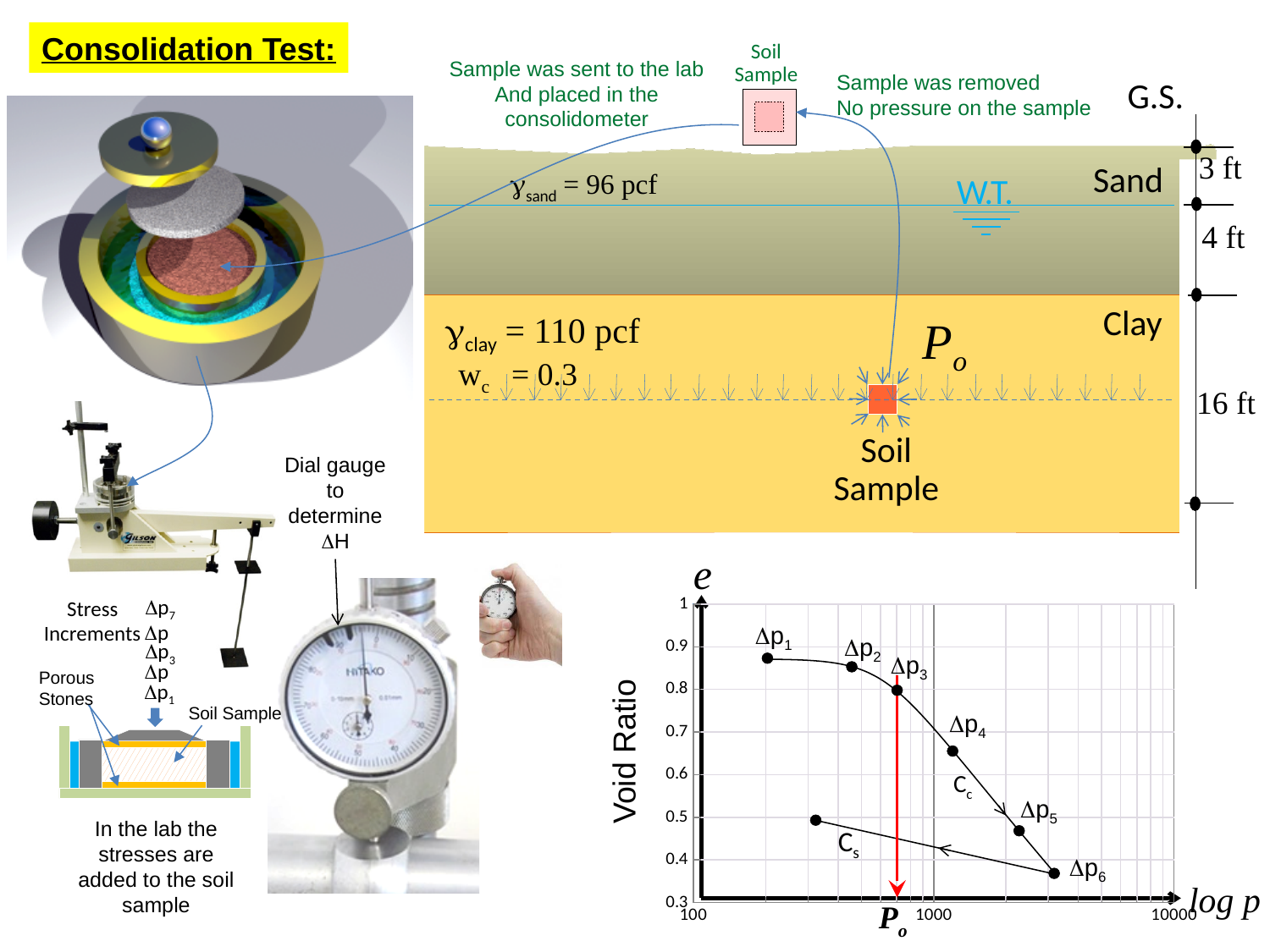
Does the void ratio rise or fall as log p increases along the loading curve from Δp1 to Δp6? fall How many labeled stress increment points (Δp) are plotted on the chart? 6 Which labeled stress increment point has the highest void ratio on the chart? Δp1 Which has a larger void ratio, Δp2 or Δp5? Δp2 Is the void ratio at Δp4 greater or less than 0.7? less Is the void ratio at Δp6 greater or less than 0.4? less Which labeled stress increment point has the lowest void ratio on the chart? Δp6 Is the void ratio at Δp1 greater or less than 0.8? greater What is the label on the horizontal axis of the chart? log p What is the lowest value shown on the vertical axis of the chart? 0.3 What is the label on the vertical axis of the chart? Void Ratio